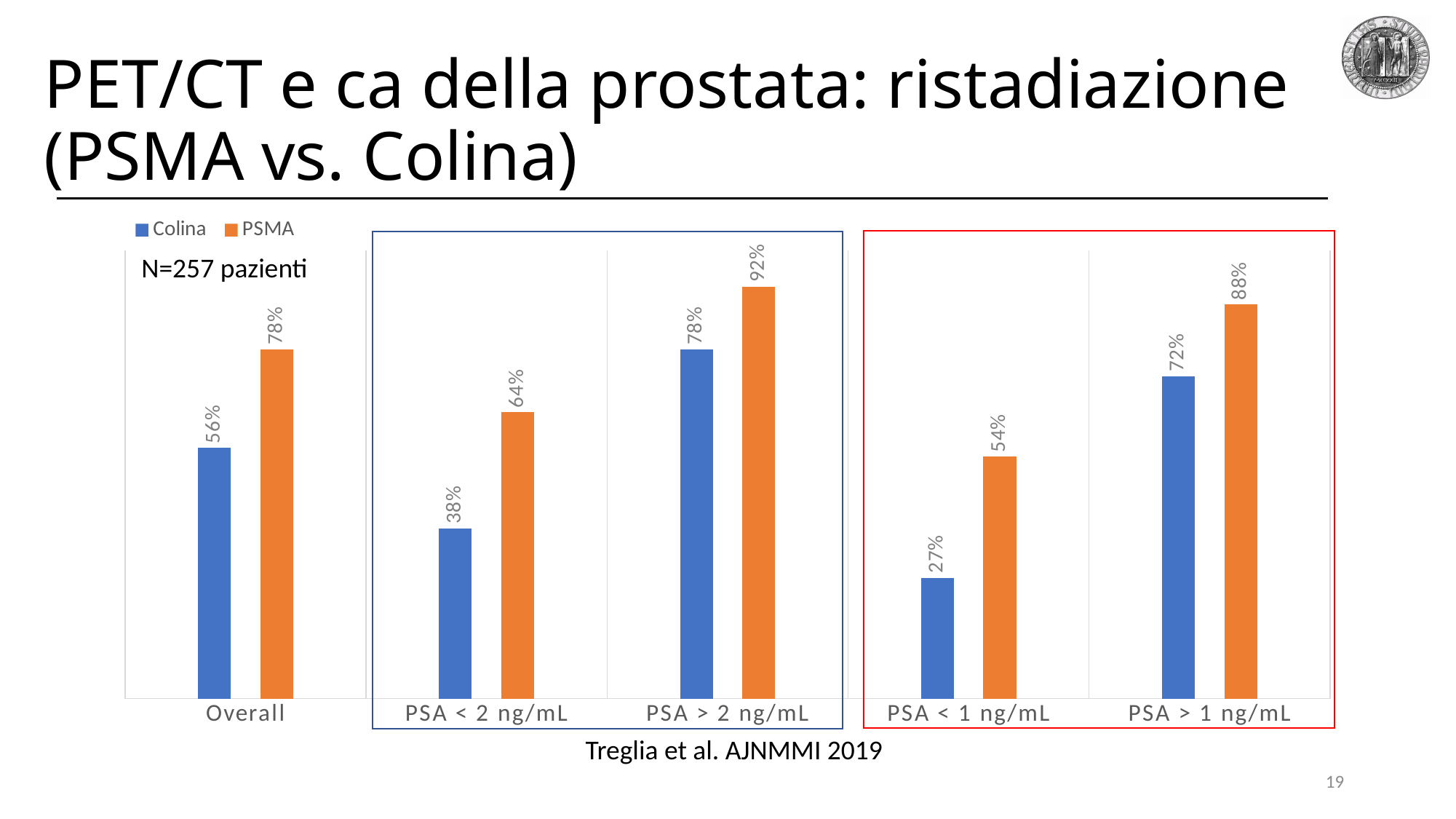
Which category has the lowest Colina value? PSA < 1 ng/mL What is the value for Colina in the PSA < 1 ng/mL category? 27% What is the difference between the PSMA and Colina values in the Overall category? 22% What kind of chart is shown on the slide? Bar chart What is the difference between the PSMA and Colina values in the PSA < 2 ng/mL category? 26% What is the value for PSMA in the Overall category? 78% What is the value for Colina in the PSA > 2 ng/mL category? 78% Which category has the highest PSMA value? PSA > 2 ng/mL How many categories are shown on the x axis? 5 Which is larger in the PSA > 1 ng/mL category, Colina or PSMA? PSMA Which colour represents the PSMA series? Orange How many series does the legend list? 2